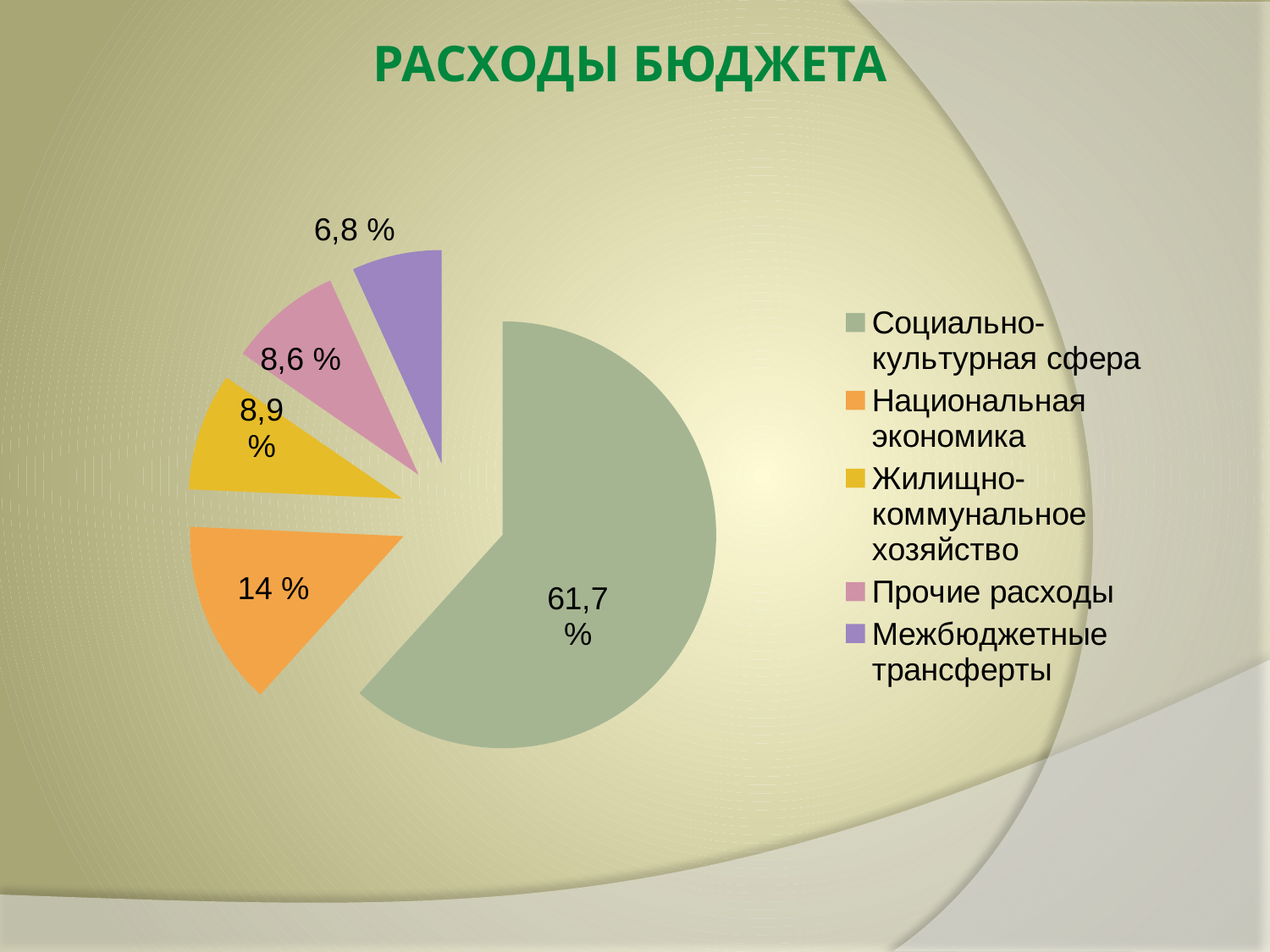
Which category has the smallest slice of the pie? Межбюджетные трансферты Which is larger, the share of Национальная экономика or the share of Межбюджетные трансферты? Национальная экономика What share of the pie is Прочие расходы? 8,6 % What share of the pie is Жилищно-коммунальное хозяйство? 8,9 % What is the difference between the shares of Социально-культурная сфера and Национальная экономика? 47,7 % What share of the pie is Межбюджетные трансферты? 6,8 % What share of the pie is Национальная экономика? 14 % How many categories does the pie chart have? 5 What kind of chart is shown on the slide? pie chart Which category has the largest slice of the pie? Социально-культурная сфера What share of the pie is Социально-культурная сфера? 61,7 % What is the title of the chart? РАСХОДЫ БЮДЖЕТА